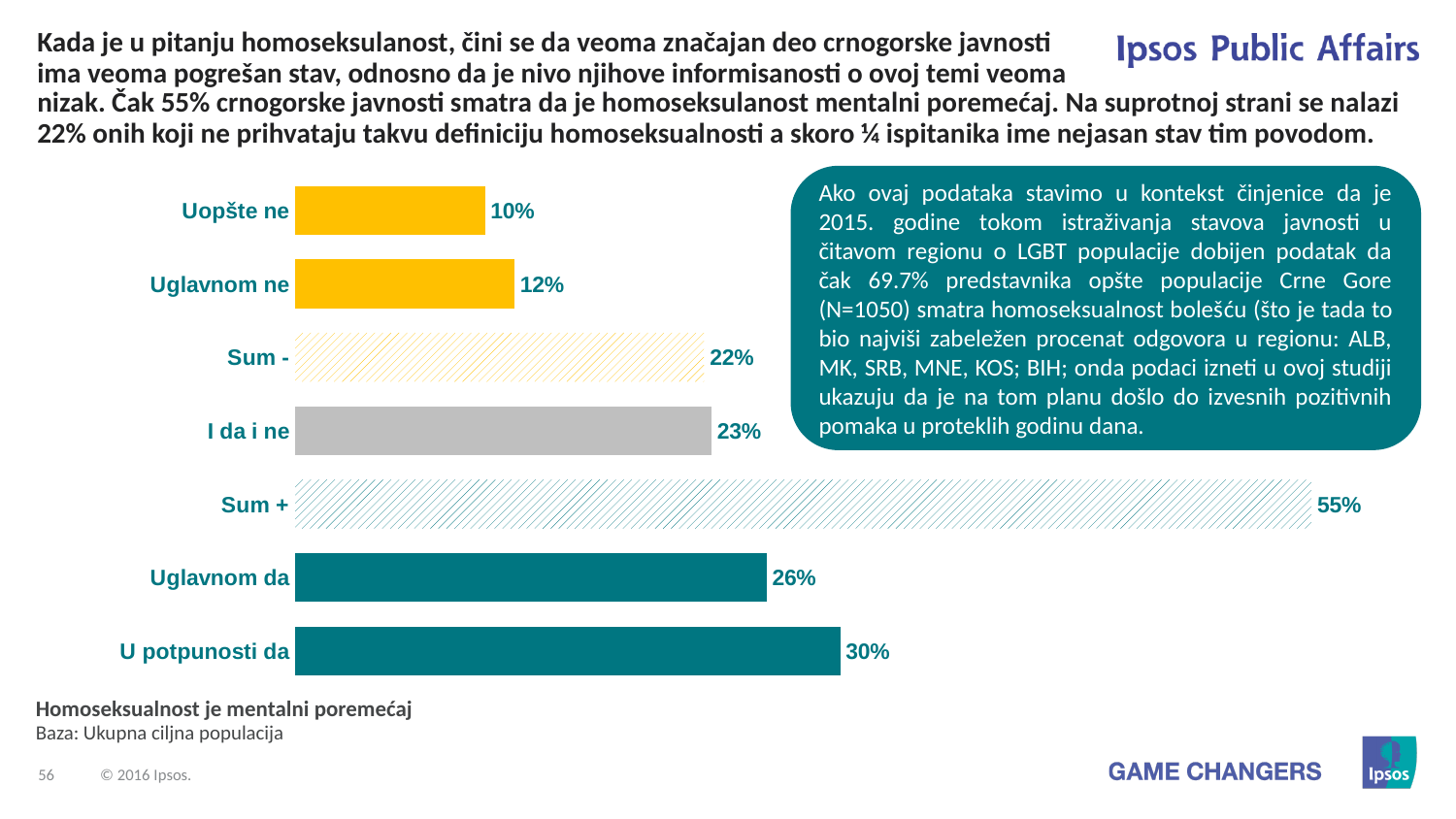
What is the title of the chart shown below the bars? Homoseksualnost je mentalni poremećaj Which category has the highest value? Sum + How many bars are shown in the chart? 7 What is the difference between "U potpunosti da" and "Uglavnom da"? 4% What is the value for "I da i ne"? 23% What is the value for "U potpunosti da"? 30% Which is larger, "Uglavnom da" or "Uglavnom ne"? Uglavnom da What is the value for "Uglavnom ne"? 12% What kind of chart is shown on the slide? Bar chart Which category has the lowest value? Uopšte ne What is the difference between "Sum +" and "Sum -"? 33% What is the value for "Sum +"? 55%